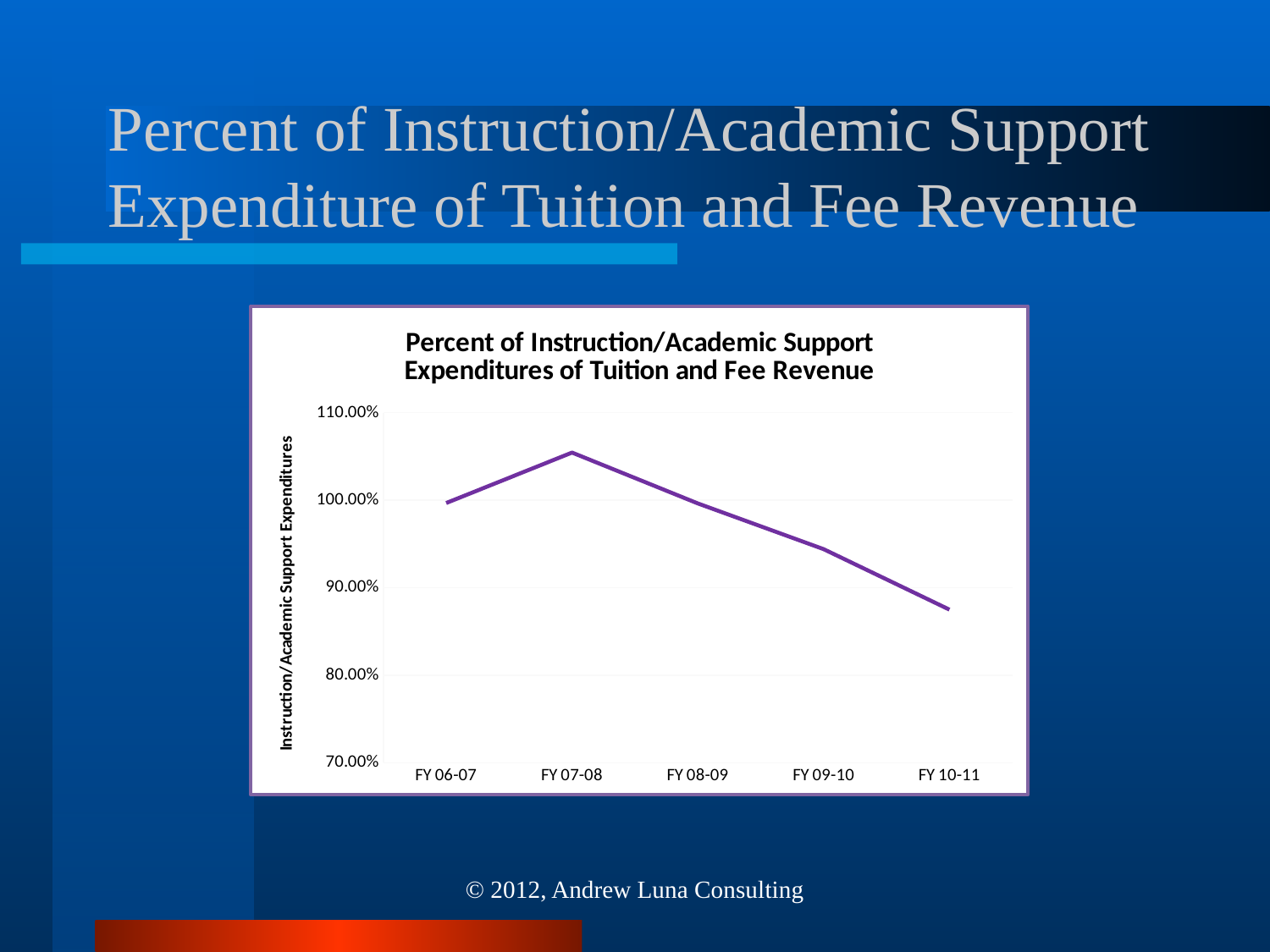
Which is larger, the value for FY 07-08 or the value for FY 10-11? FY 07-08 What is the title of the chart? Percent of Instruction/Academic Support Expenditures of Tuition and Fee Revenue Is the value for FY 07-08 greater or less than 100.00%? greater Which fiscal year has the highest value? FY 07-08 Does the line rise or fall from FY 07-08 to FY 10-11? fall How many fiscal years are plotted on the x axis? 5 What is the label on the vertical axis of the chart? Instruction/Academic Support Expenditures Is the value for FY 10-11 greater or less than 90.00%? less What kind of chart is shown on the slide? line chart Is the value for FY 08-09 greater or less than 90.00%? greater Which fiscal year has the lowest value? FY 10-11